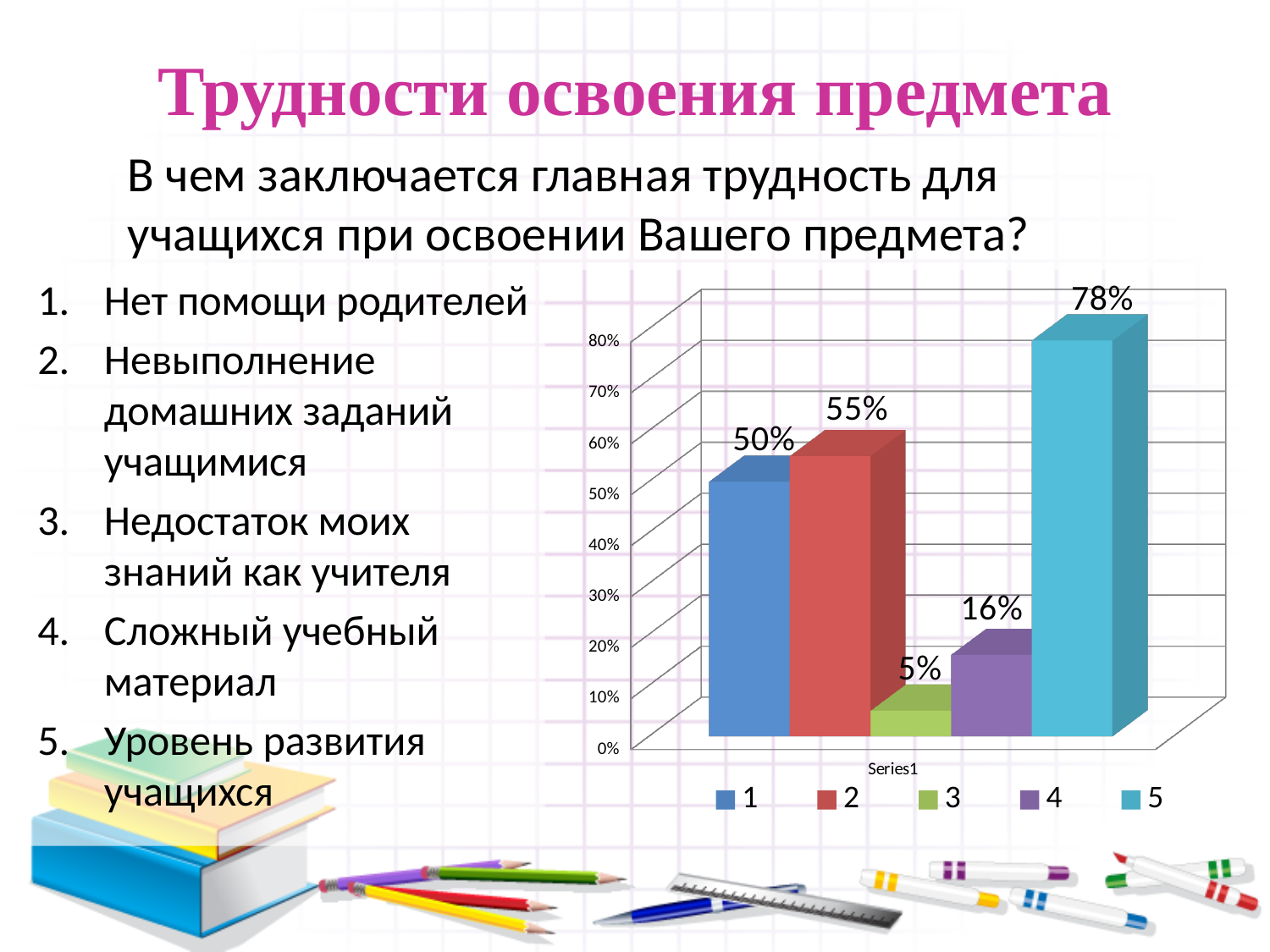
Which series has the highest value in the chart? 5 What is the value shown for series 2 in the chart? 55% What is the category label shown on the x axis of the chart? Series1 What is the value shown for series 3 in the chart? 5% Which series has the lowest value in the chart? 3 Which is larger, the value for series 1 or the value for series 2? 2 How many series does the legend list? 5 What is the difference between the values for series 5 and series 2? 23% What is the value shown for series 4 in the chart? 16% What is the value shown for series 1 in the chart? 50% What is the value shown for series 5 in the chart? 78% What kind of chart is shown on the slide? bar chart